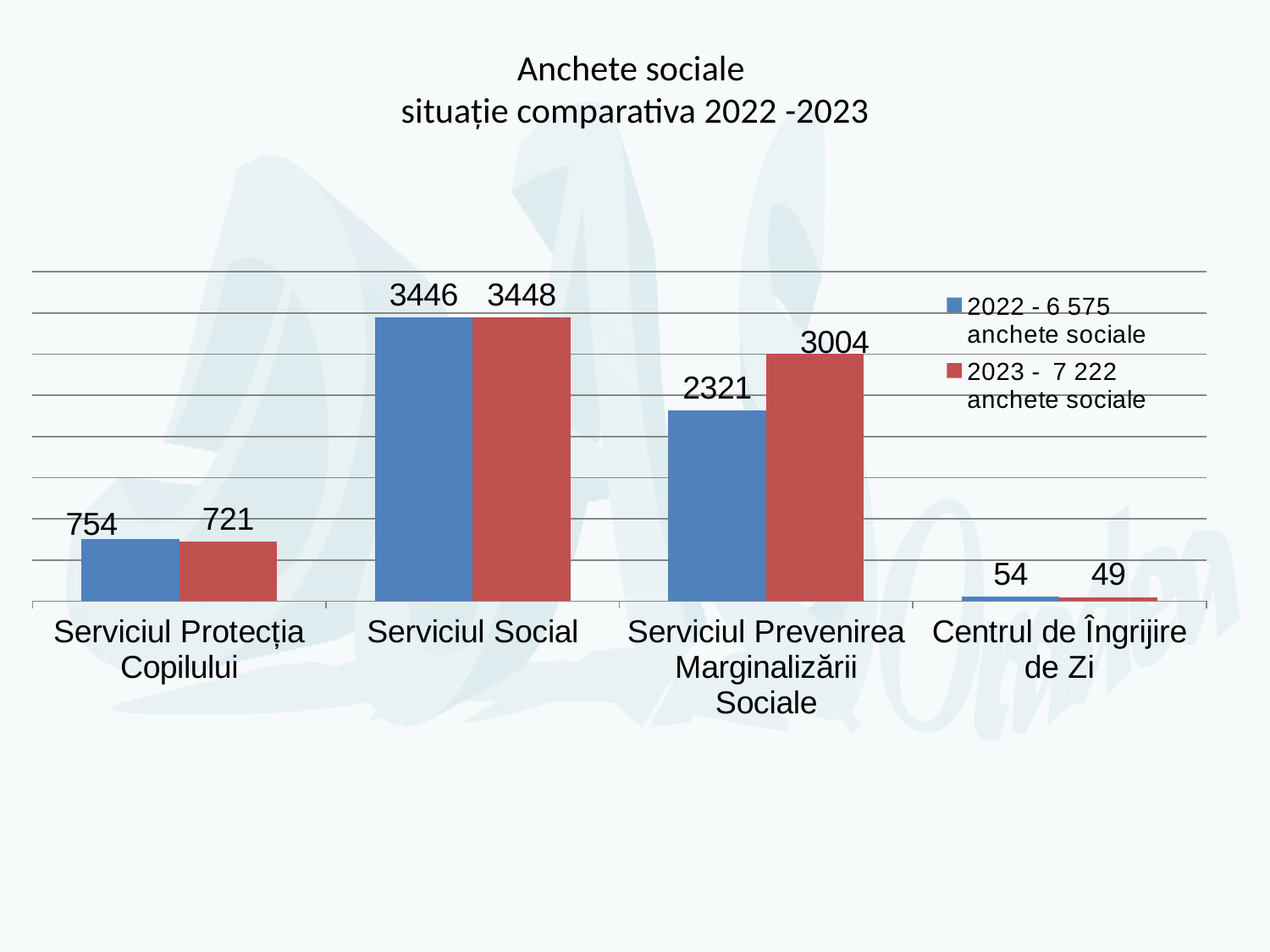
Which category has the highest 2023 value? Serviciul Social How many series does the legend list? 2 What is the 2023 value for Serviciul Prevenirea Marginalizării Sociale? 3004 How many categories are shown on the x axis? 4 What is the difference between the 2023 and 2022 values for Serviciul Prevenirea Marginalizării Sociale? 683 What is the 2023 value for Serviciul Protecția Copilului? 721 For Serviciul Protecția Copilului, which year has the larger value, 2022 or 2023? 2022 Which category has the lowest 2022 value? Centrul de Îngrijire de Zi What kind of chart is shown on the slide? Bar chart What is the difference between the 2022 and 2023 values for Serviciul Protecția Copilului? 33 What is the 2022 value for Centrul de Îngrijire de Zi? 54 What is the 2022 value for Serviciul Social? 3446